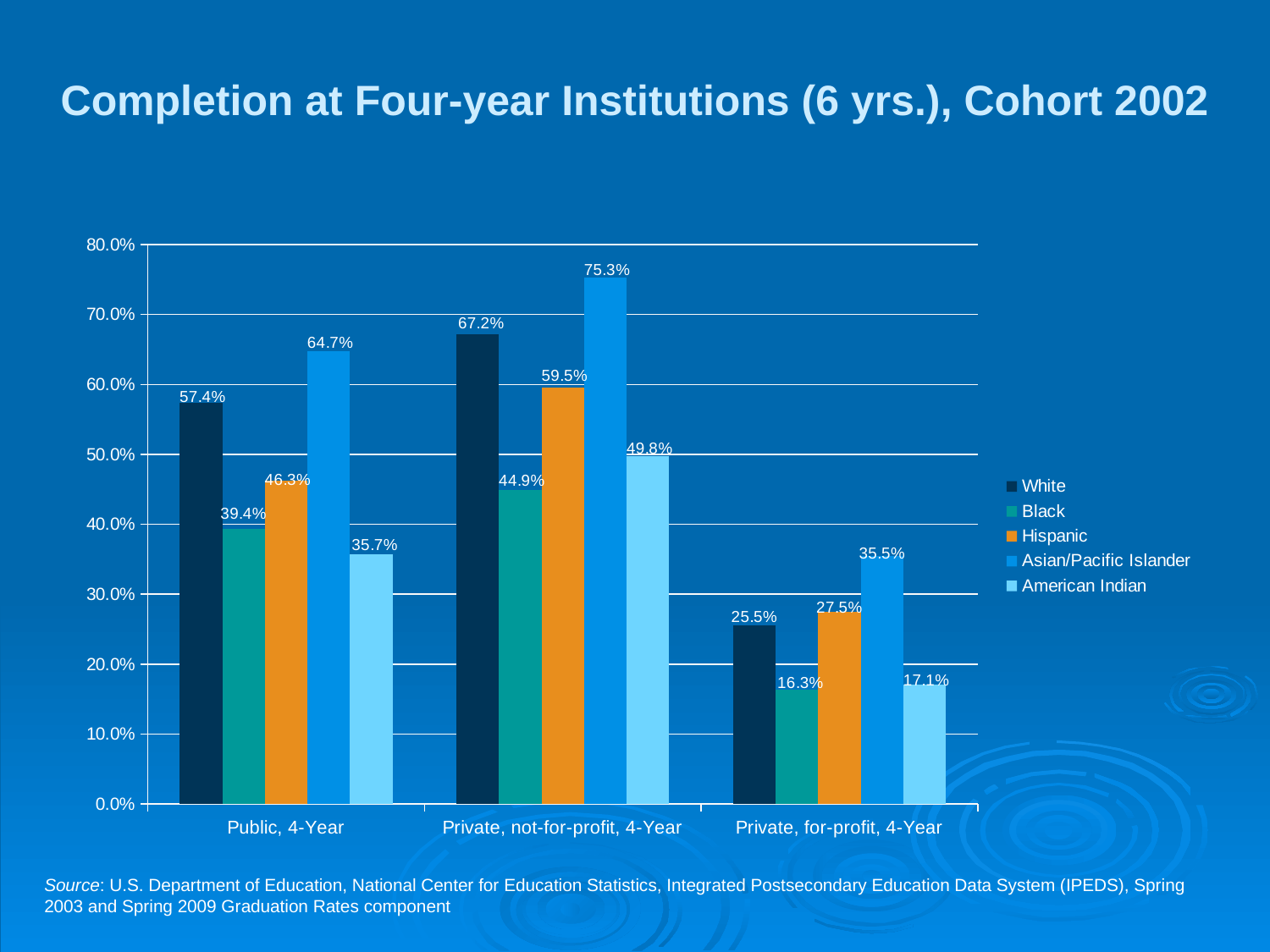
What is the title of the chart? Completion at Four-year Institutions (6 yrs.), Cohort 2002 Which is larger: the Hispanic completion rate at Public, 4-Year institutions or at Private, not-for-profit, 4-Year institutions? Private, not-for-profit, 4-Year How many institution types are shown on the x axis? 3 What is the completion rate for White students at Public, 4-Year institutions? 57.4% Is the American Indian completion rate at Public, 4-Year institutions greater or less than 40.0%? less What kind of chart is shown on the slide? bar chart What is the completion rate for Asian/Pacific Islander students at Private, not-for-profit, 4-Year institutions? 75.3% What is the completion rate for Black students at Private, for-profit, 4-Year institutions? 16.3% Which group has the highest completion rate at Public, 4-Year institutions? Asian/Pacific Islander How many series does the legend list? 5 Which group has the lowest completion rate at Private, for-profit, 4-Year institutions? Black What is the difference between the White and Black completion rates at Private, not-for-profit, 4-Year institutions? 22.3%